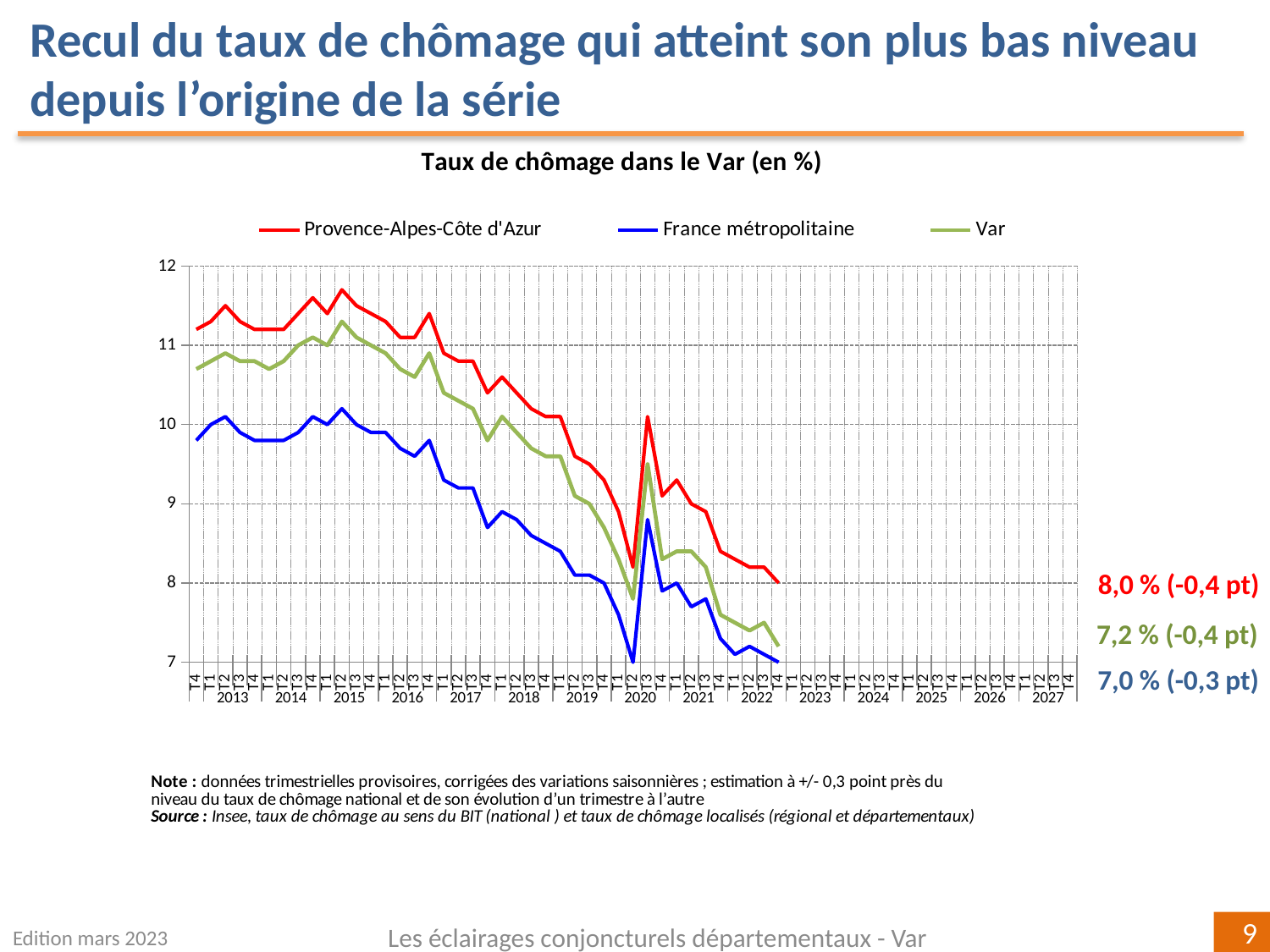
Which series has the lowest value at the end of the series (T4 2022)? France métropolitaine What is the latest unemployment rate shown for France métropolitaine? 7,0 % By how many points did the Var unemployment rate change in the latest quarter, according to the annotation? -0,4 pt What is the title of the chart? Taux de chômage dans le Var (en %) Which series is drawn in green? Var What is the latest unemployment rate shown for the Var? 7,2 % How many series does the legend list? 3 What is the latest unemployment rate shown for Provence-Alpes-Côte d'Azur? 8,0 % Which series has the highest value at the end of the series (T4 2022)? Provence-Alpes-Côte d'Azur What is the difference between the latest Provence-Alpes-Côte d'Azur rate and the latest France métropolitaine rate? 1,0 point Is the peak value of the Provence-Alpes-Côte d'Azur line in 2015 greater or less than 11? greater What kind of chart is shown on the slide? line chart